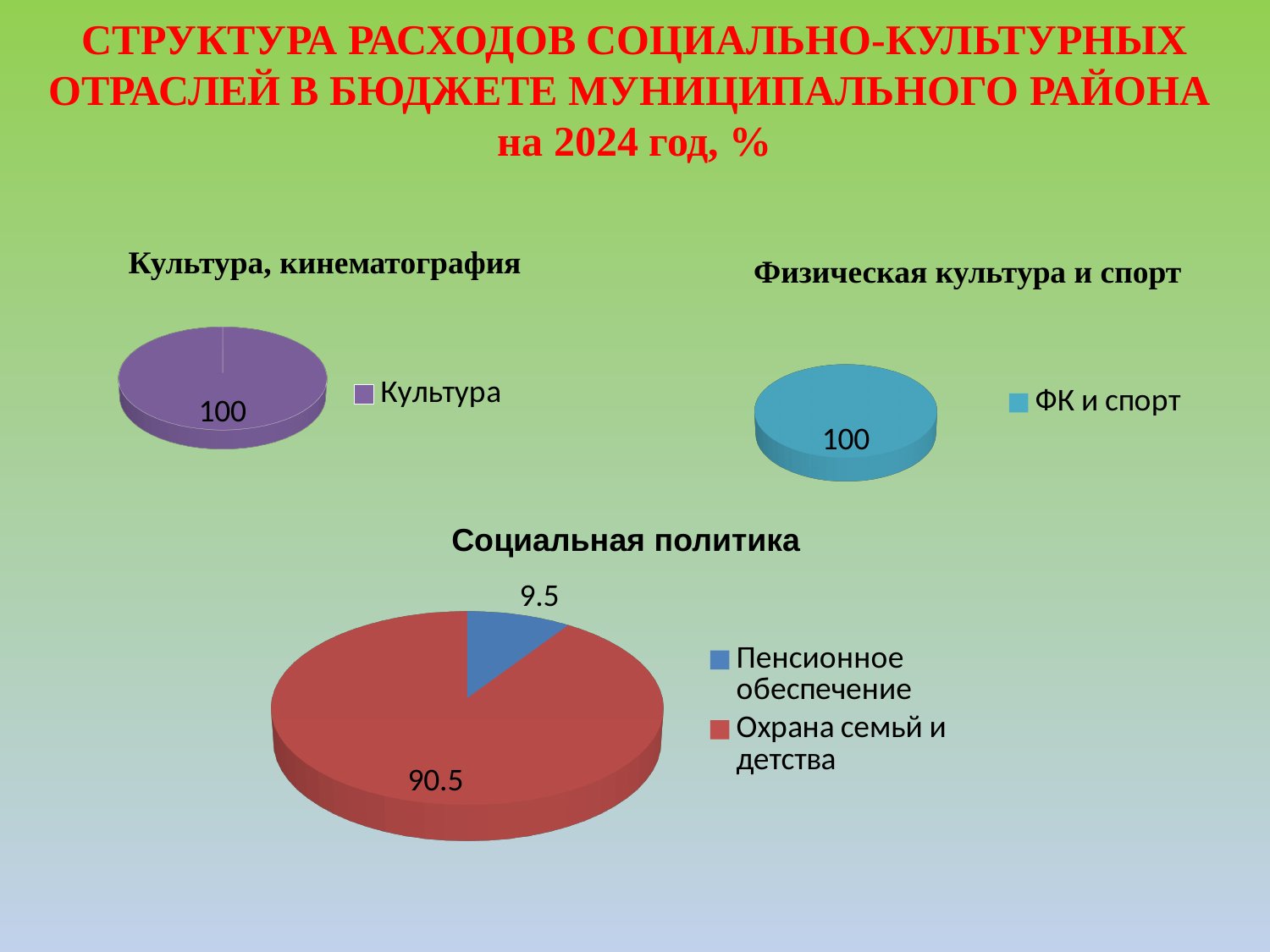
In the 'Культура, кинематография' chart, what is the value for 'Культура'? 100 In the 'Социальная политика' chart, which is larger: 'Пенсионное обеспечение' or 'Охрана семьи и детства'? Охрана семьй и детства What kind of chart is the 'Социальная политика' chart? Pie chart In the 'Социальная политика' chart, what is the value for 'Охрана семьи и детства'? 90.5 How many charts are shown on the slide? 3 In the 'Социальная политика' chart, what is the value for 'Пенсионное обеспечение'? 9.5 In the 'Социальная политика' chart, what is the difference between 'Охрана семьи и детства' and 'Пенсионное обеспечение'? 81 In the 'Социальная политика' chart, which category has the smallest slice? Пенсионное обеспечение How many slices does the 'Социальная политика' chart have? 2 How many entries does the legend of the 'Социальная политика' chart list? 2 In the 'Физическая культура и спорт' chart, what is the value for 'ФК и спорт'? 100 In the 'Социальная политика' chart, which category has the largest slice? Охрана семьй и детства